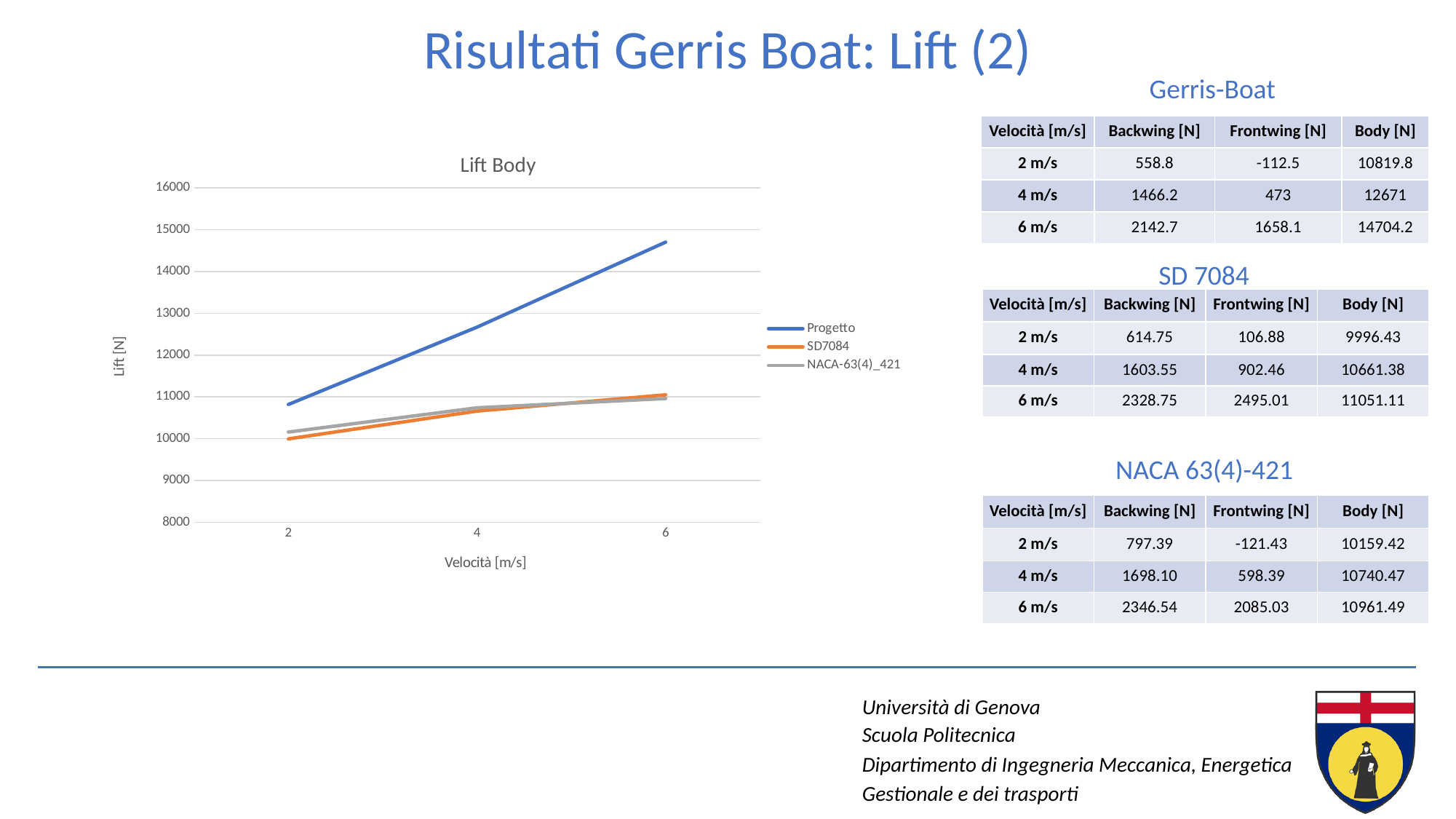
What type of chart is the "Lift Body" chart? line chart Which series in the "Lift Body" chart is drawn in orange? SD7084 In the "Lift Body" chart, is the SD7084 value at 4 m/s greater or less than 11000? less In the "Lift Body" chart, which is larger at 4 m/s: Progetto or NACA-63(4)_421? Progetto Which series has the lowest lift at 2 m/s in the "Lift Body" chart? SD7084 How many velocity points are plotted along the x axis of the "Lift Body" chart? 3 How many series does the legend of the "Lift Body" chart list? 3 Which series has the highest lift at 6 m/s in the "Lift Body" chart? Progetto Does the Progetto series in the "Lift Body" chart rise or fall as velocity increases from 2 to 6 m/s? rise In the "Lift Body" chart, is the Progetto value at 6 m/s greater or less than 14000? greater What is the label of the y axis in the "Lift Body" chart? Lift [N] In the "Lift Body" chart, is the Progetto value at 4 m/s greater or less than 12000? greater